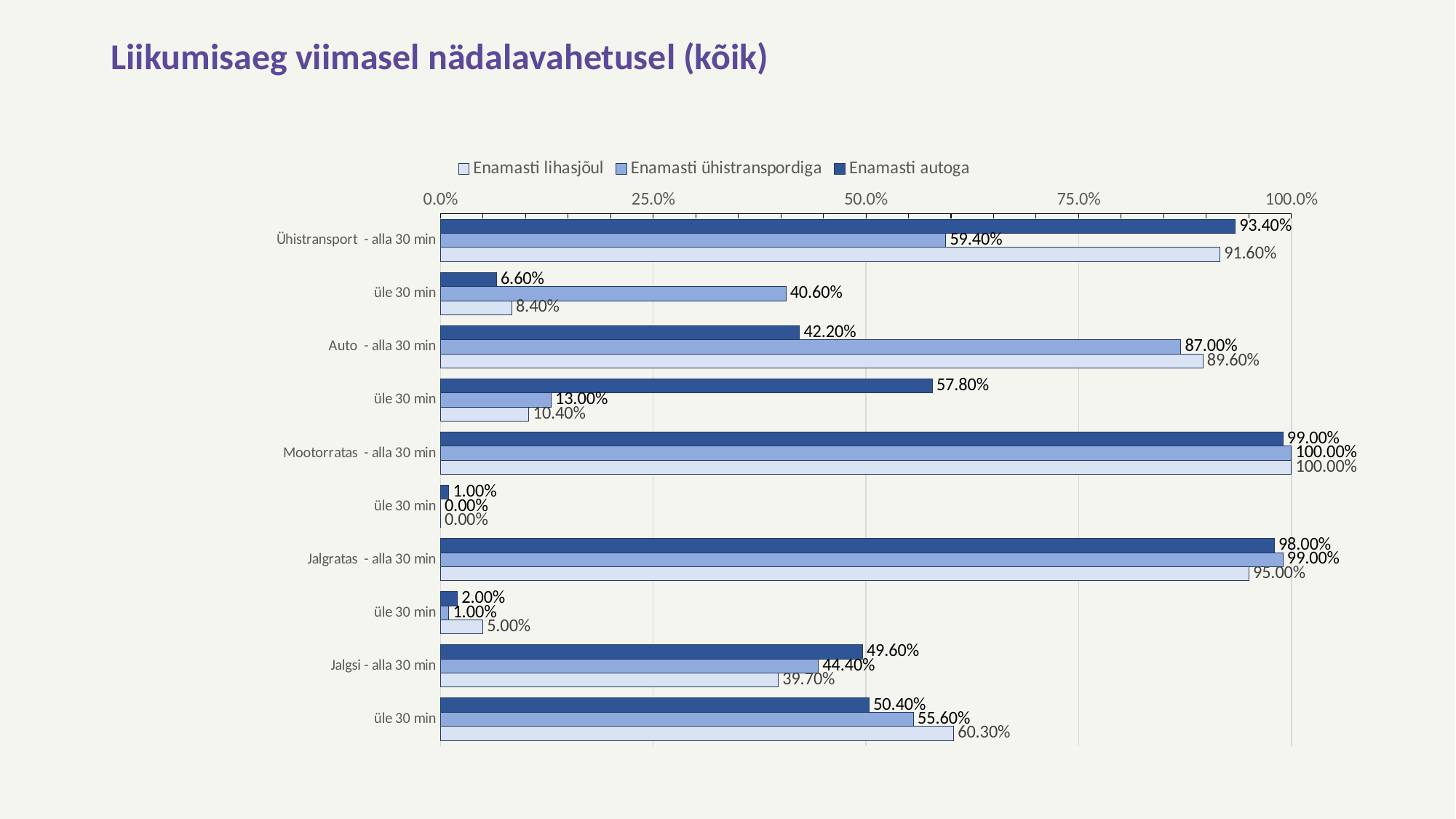
What is the title of the slide? Liikumisaeg viimasel nädalavahetusel (kõik) What is the difference between Enamasti autoga and Enamasti ühistranspordiga for 'Ühistransport - alla 30 min'? 34.00% What is the value of Enamasti lihasjõul for 'Jalgsi - alla 30 min'? 39.70% What kind of chart is shown on the slide? bar chart Which category has the lowest Enamasti autoga value? üle 30 min (under Mootorratas) Which is larger for 'Jalgsi - alla 30 min': Enamasti autoga or Enamasti lihasjõul? Enamasti autoga How many series does the legend list? 3 How many categories are shown on the vertical axis? 10 What is the value of Enamasti autoga for the 'üle 30 min' row under Auto? 57.80% What is the value of Enamasti autoga for 'Ühistransport - alla 30 min'? 93.40% Which series has the highest value for 'Auto - alla 30 min'? Enamasti lihasjõul What is the value of Enamasti ühistranspordiga for 'Auto - alla 30 min'? 87.00%